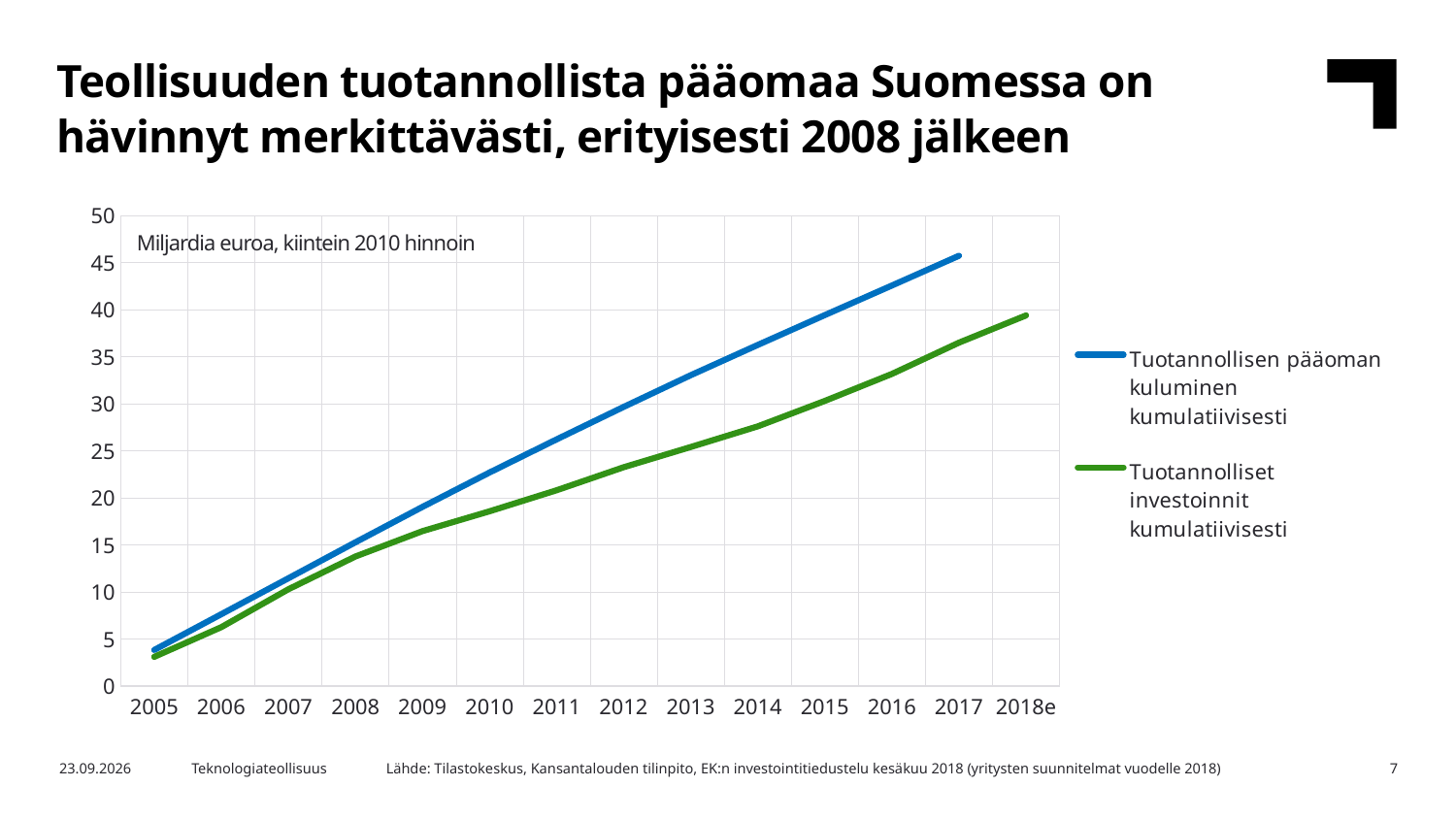
How many years are shown on the x axis? 14 Is the value for 'Tuotannolliset investoinnit kumulatiivisesti' in 2005 greater or less than 5? less Is the value for 'Tuotannollisen pääoman kuluminen kumulatiivisesti' in 2015 greater or less than 35? greater What colour is the line for 'Tuotannolliset investoinnit kumulatiivisesti'? green What kind of chart is shown on the slide? line chart Is the value for 'Tuotannolliset investoinnit kumulatiivisesti' in 2018e greater or less than 35? greater How many series does the legend list? 2 Do the values of the 'Tuotannollisen pääoman kuluminen kumulatiivisesti' series rise or fall from 2005 to 2018e? rise What unit is stated in the note inside the chart area? Miljardia euroa, kiintein 2010 hinnoin